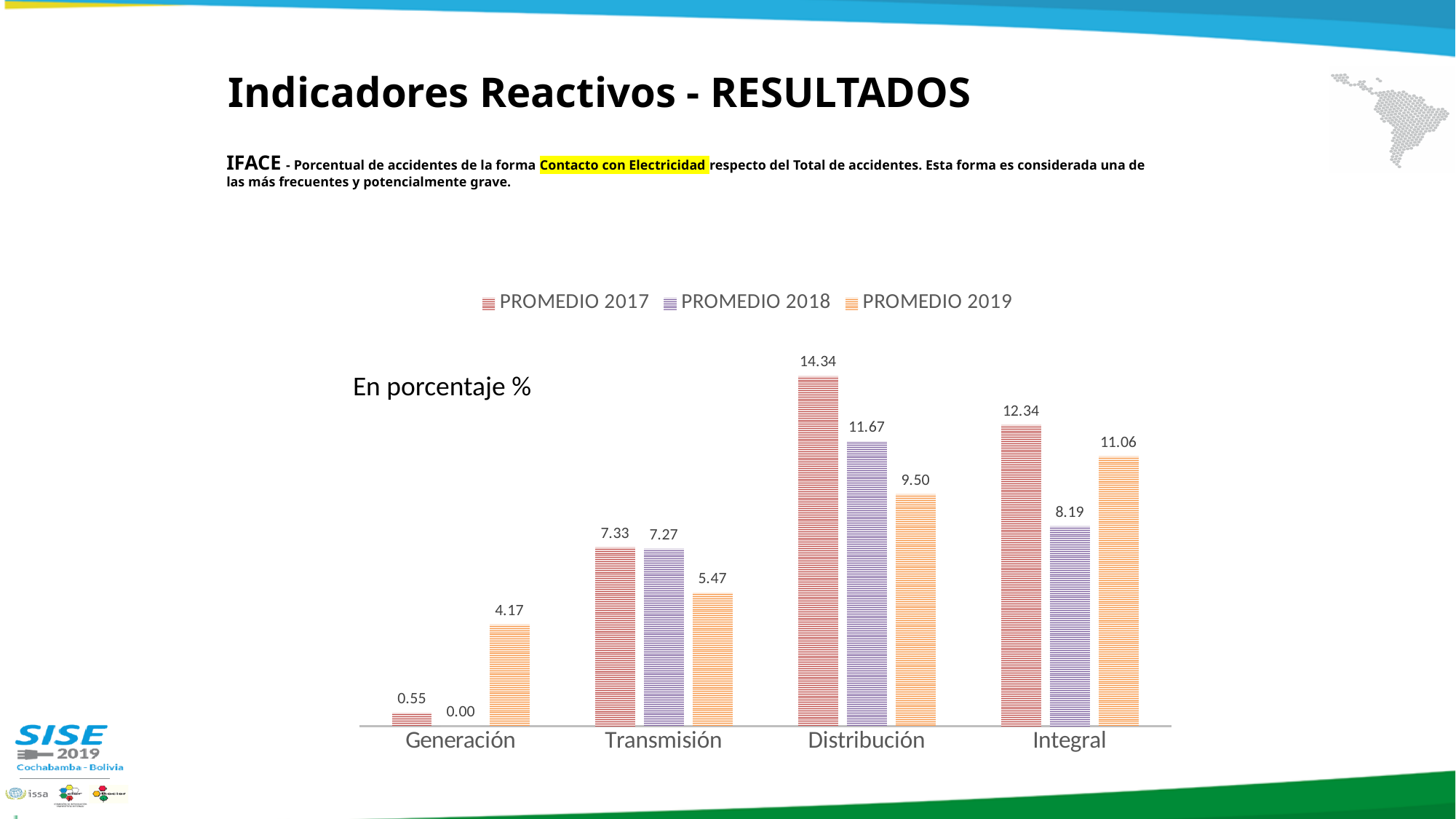
Which category has the highest PROMEDIO 2017 value? Distribución What kind of chart is shown on the slide? Bar chart What is the PROMEDIO 2019 value for Generación? 4.17 Which is larger for Transmisión: the PROMEDIO 2017 value or the PROMEDIO 2019 value? PROMEDIO 2017 How many categories are shown on the x axis? 4 What is the PROMEDIO 2018 value for Integral? 8.19 How many series does the legend list? 3 What unit label is shown next to the chart? En porcentaje % What is the PROMEDIO 2017 value for Distribución? 14.34 What is the difference between the PROMEDIO 2017 and PROMEDIO 2019 values for Integral? 1.28 Which category has the lowest PROMEDIO 2019 value? Generación What is the PROMEDIO 2018 value for Generación? 0.00